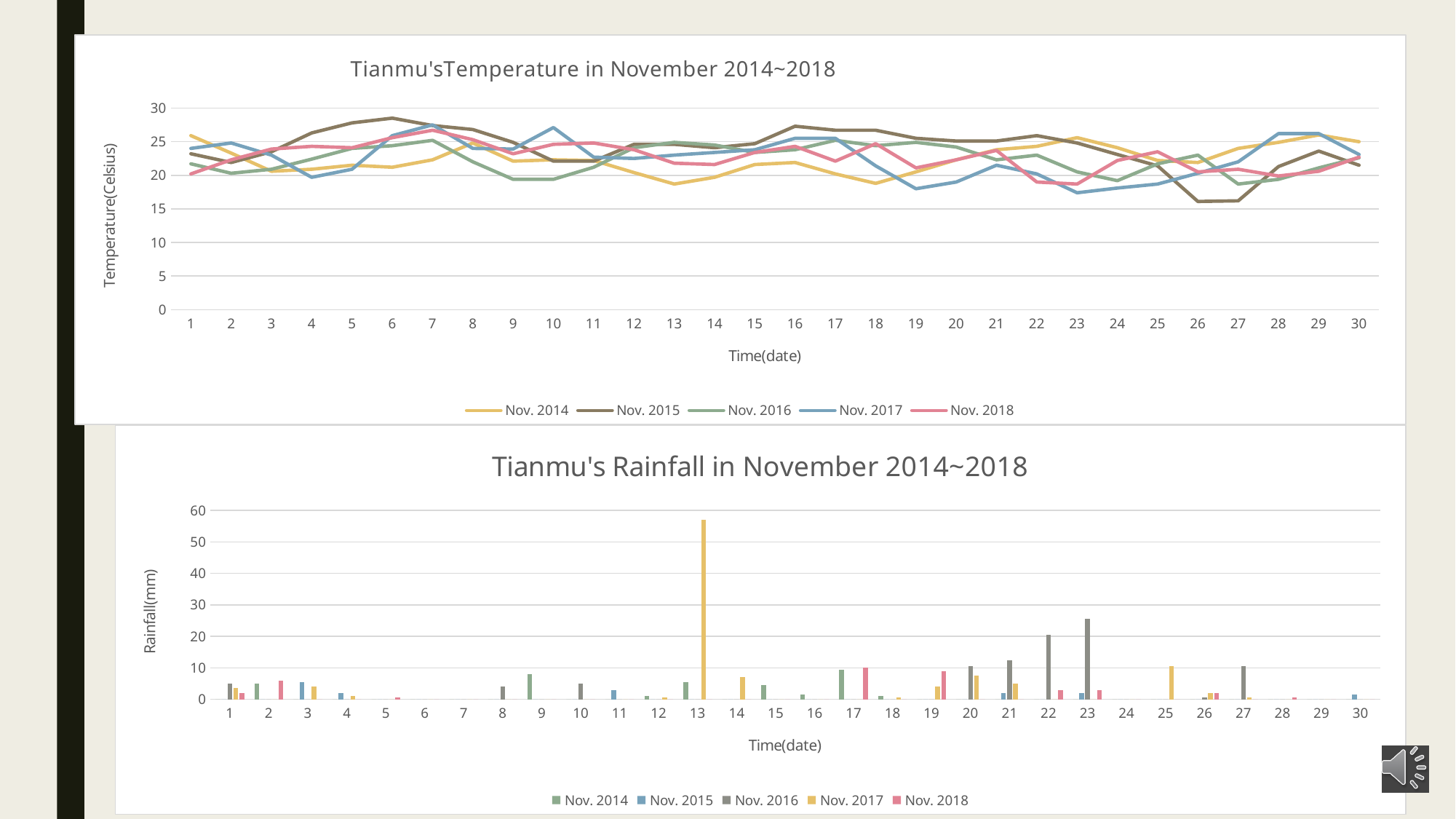
What kind of chart is the top chart, 'Tianmu'sTemperature in November 2014~2018'? line chart In the bottom rainfall chart, how many dates are shown along the x axis? 30 In the top temperature chart, is the Nov. 2015 value on date 6 greater or less than 25? greater In the top temperature chart, is the Nov. 2015 value on date 26 greater or less than 20? less What is the y-axis label of the bottom rainfall chart? Rainfall(mm) In the top temperature chart, how many series does the legend list? 5 What kind of chart is the bottom chart, 'Tianmu's Rainfall in November 2014~2018'? bar chart In the bottom rainfall chart, which series has the highest bar on date 13? Nov. 2017 In the bottom rainfall chart, is the Nov. 2016 value on date 23 greater or less than 20? greater In the bottom rainfall chart, which is larger: the Nov. 2017 bar on date 13 or the Nov. 2016 bar on date 23? Nov. 2017 bar on date 13